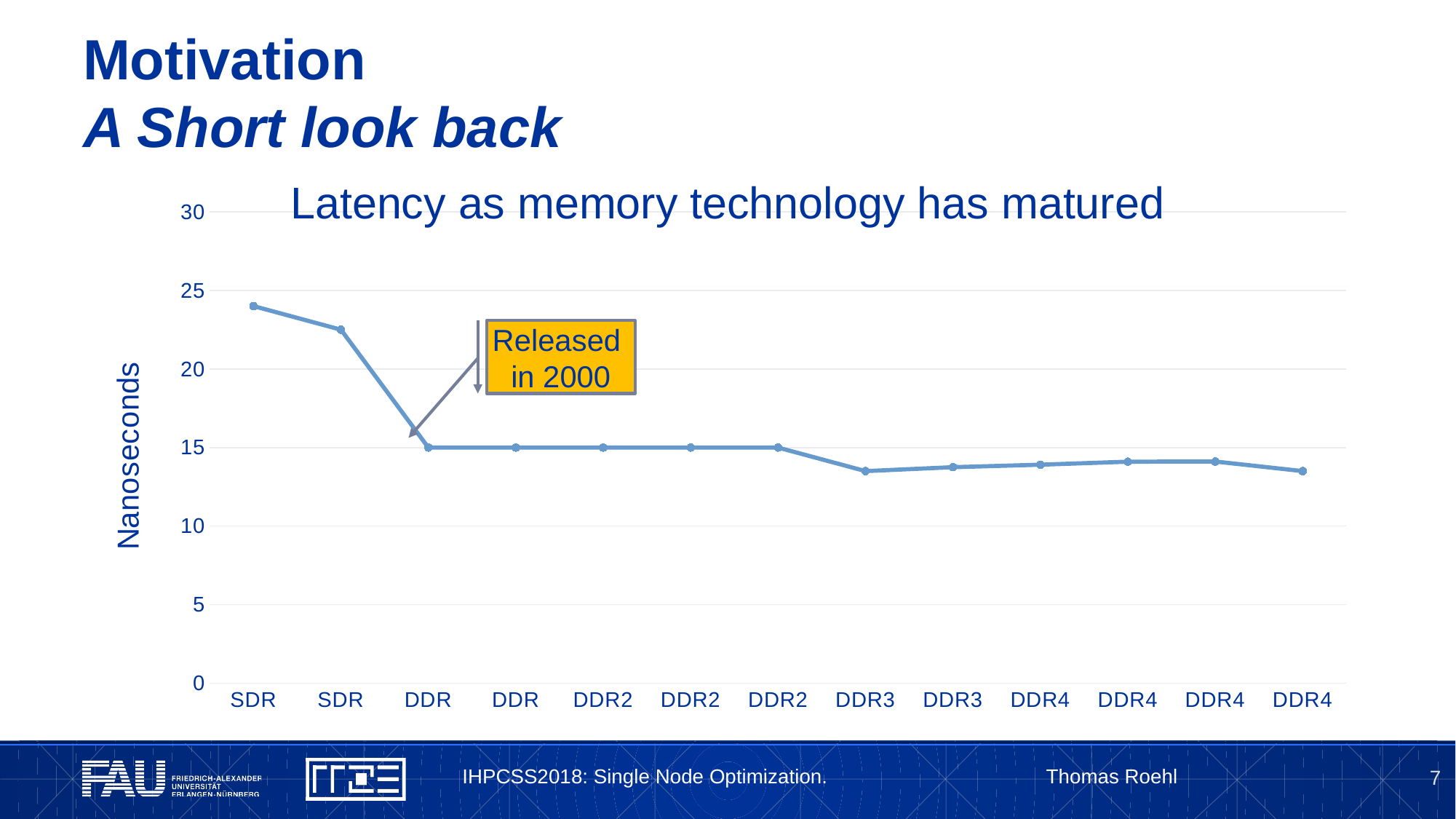
Do the latency values generally rise or fall from SDR to DDR4 along the x axis? fall What is the label on the vertical axis of the chart? Nanoseconds Which has the larger latency value, the first SDR point or the first DDR point? SDR What latency value do the DDR and DDR2 points land on? 15 Which category has the highest latency value on the chart? SDR (the first point) Is the value for the first SDR point greater or less than 25? less Is the value for the first DDR3 point greater or less than 15? less What kind of chart is shown on the slide? line chart Is the value for the last DDR4 point greater or less than 10? greater What is the title of the chart? Latency as memory technology has matured How many data points are plotted on the chart? 13